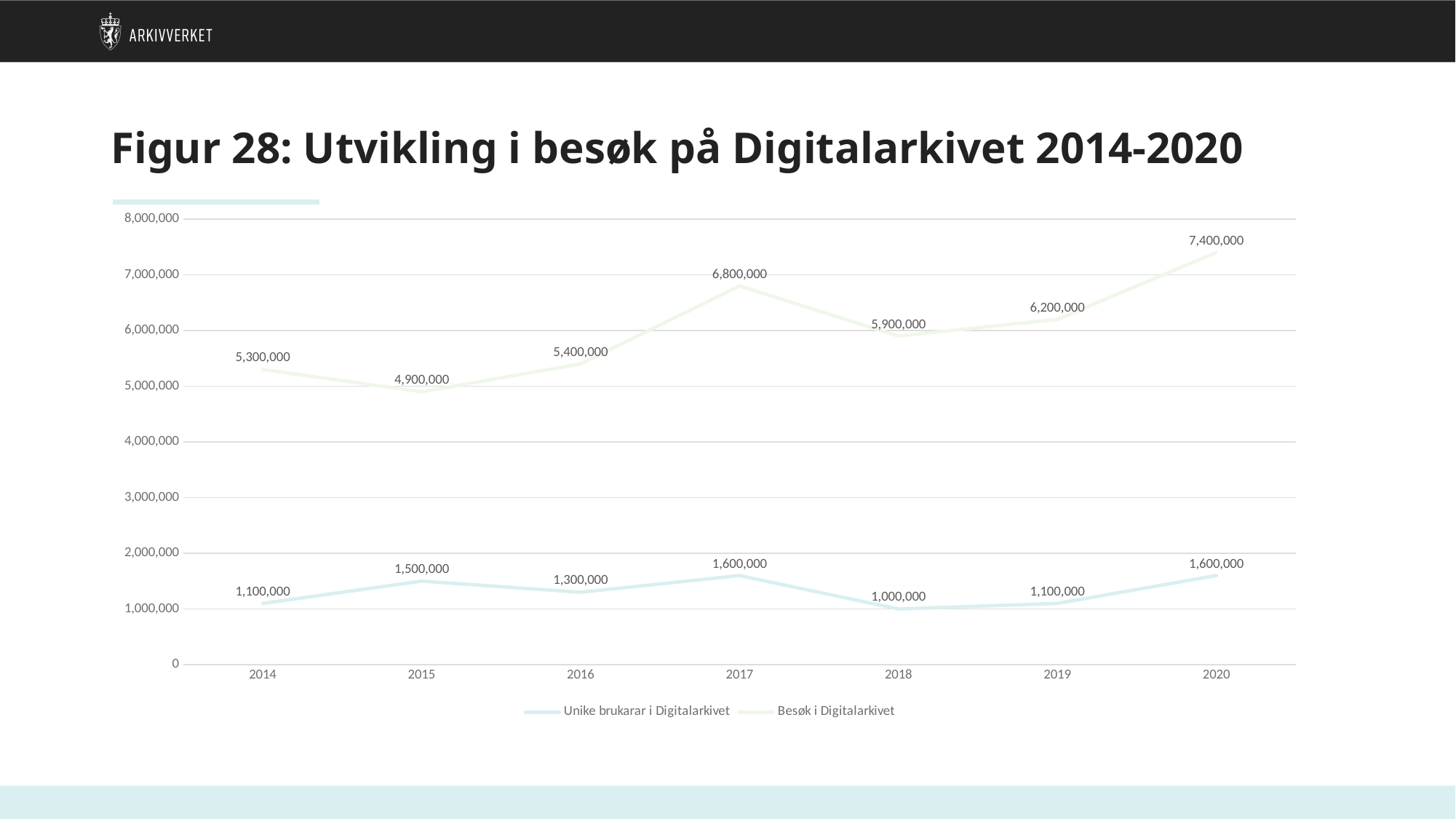
In which year is Besøk i Digitalarkivet highest? 2020 How many years are shown on the x axis? 7 Which is larger: Besøk i Digitalarkivet in 2016 or in 2018? 2018 In which year is Unike brukarar i Digitalarkivet lowest? 2018 What is the value for Besøk i Digitalarkivet in 2017? 6,800,000 What kind of chart is shown on the slide? line chart What is the title of the chart? Figur 28: Utvikling i besøk på Digitalarkivet 2014-2020 What is the value for Unike brukarar i Digitalarkivet in 2015? 1,500,000 How many series does the legend list? 2 What is the difference between Besøk i Digitalarkivet in 2020 and in 2014? 2,100,000 Is the value for Besøk i Digitalarkivet in 2015 greater or less than 5,000,000? less Does Besøk i Digitalarkivet rise or fall from 2018 to 2020? rise